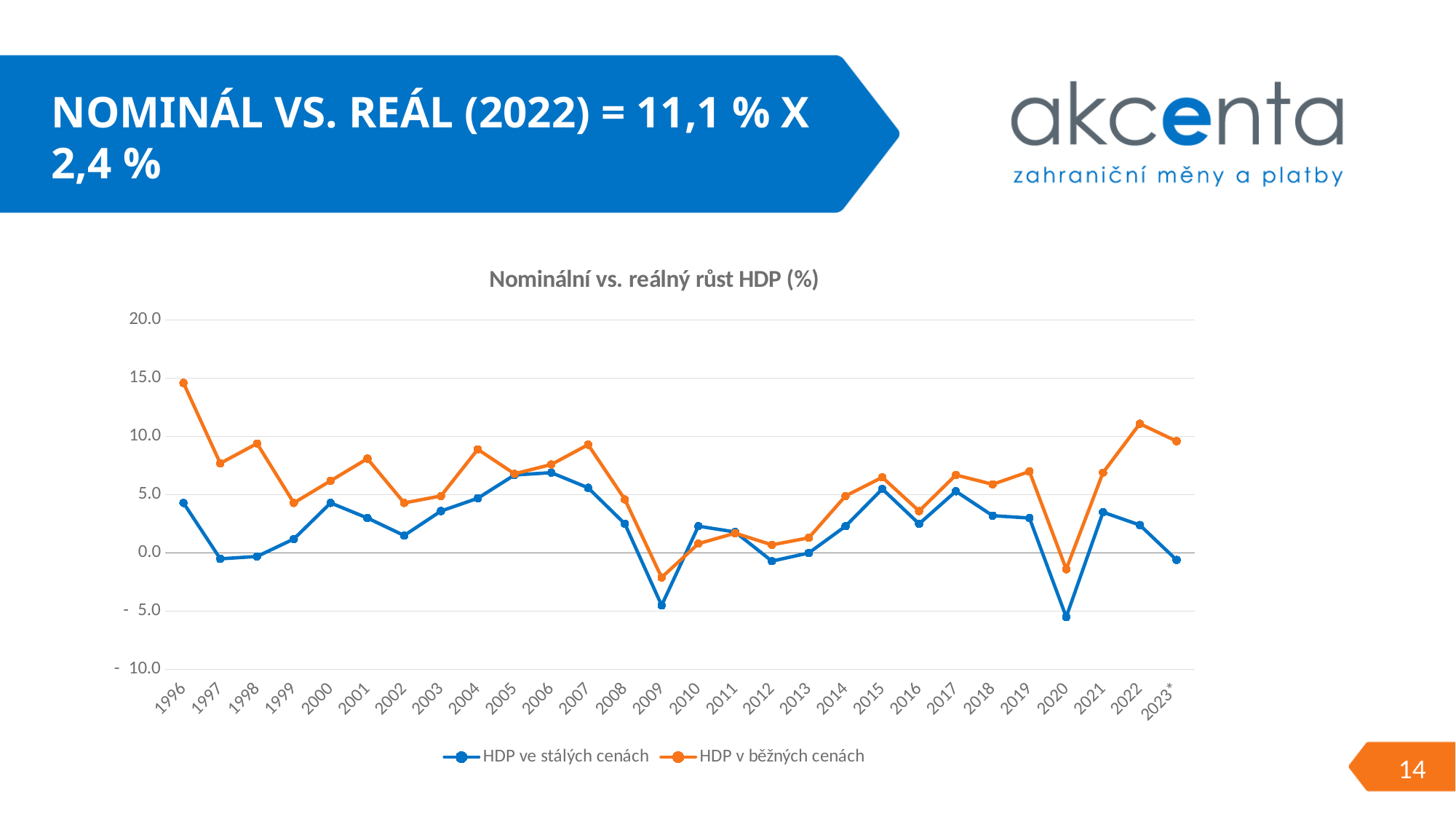
What is the title of the chart? Nominální vs. reálný růst HDP (%) In 2022, which series has the larger value, HDP ve stálých cenách or HDP v běžných cenách? HDP v běžných cenách In which year does the HDP ve stálých cenách series reach its lowest value? 2020 Is the value for HDP ve stálých cenách in 2009 greater or less than 0.0? less How many series does the legend list? 2 Which series is drawn in orange? HDP v běžných cenách Does the HDP ve stálých cenách series rise or fall from 2017 to 2020? fall What kind of chart is shown on the slide? line chart How many years are plotted along the x axis? 28 In which year does the HDP v běžných cenách series reach its highest value? 1996 Is the value for HDP v běžných cenách in 2022 greater or less than 10.0? greater Is the value for HDP v běžných cenách in 1996 greater or less than 10.0? greater